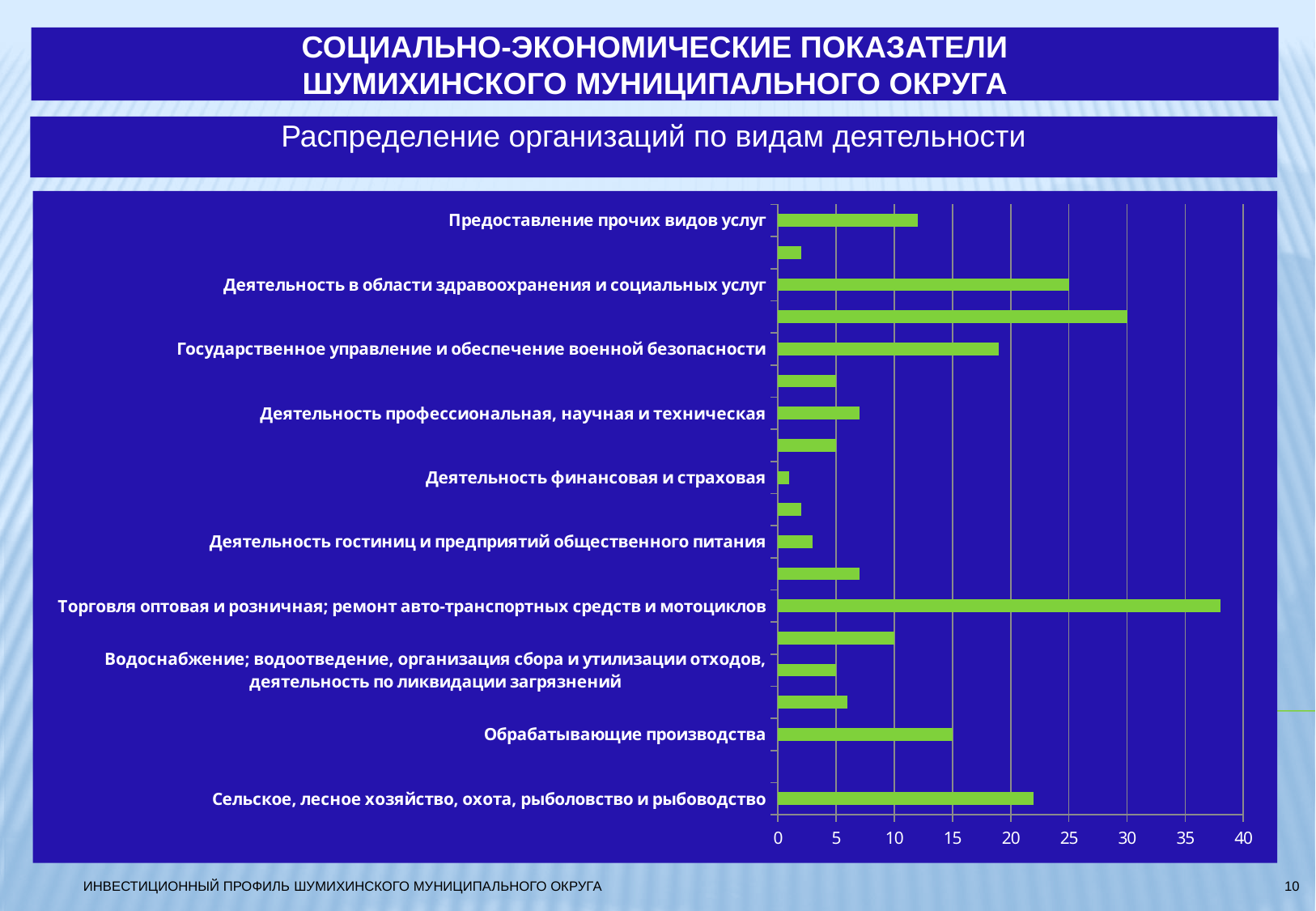
What is the title of the chart? Распределение организаций по видам деятельности Which is larger: the value for Деятельность в области здравоохранения и социальных услуг or for Государственное управление и обеспечение военной безопасности? Деятельность в области здравоохранения и социальных услуг Is the value for Торговля оптовая и розничная; ремонт авто-транспортных средств и мотоциклов greater or less than 35? greater What is the value for Деятельность в области здравоохранения и социальных услуг? 25 What is the difference between the values for Деятельность в области здравоохранения и социальных услуг and Обрабатывающие производства? 10 Which labelled category has the lowest value? Деятельность финансовая и страховая What type of chart is shown on the slide? bar chart Is the value for Деятельность гостиниц и предприятий общественного питания greater or less than 5? less Which category has the highest value? Торговля оптовая и розничная; ремонт авто-транспортных средств и мотоциклов What is the value for Водоснабжение; водоотведение, организация сбора и утилизации отходов, деятельность по ликвидации загрязнений? 5 What is the value for Обрабатывающие производства? 15 Is the value for Сельское, лесное хозяйство, охота, рыболовство и рыбоводство greater or less than 20? greater